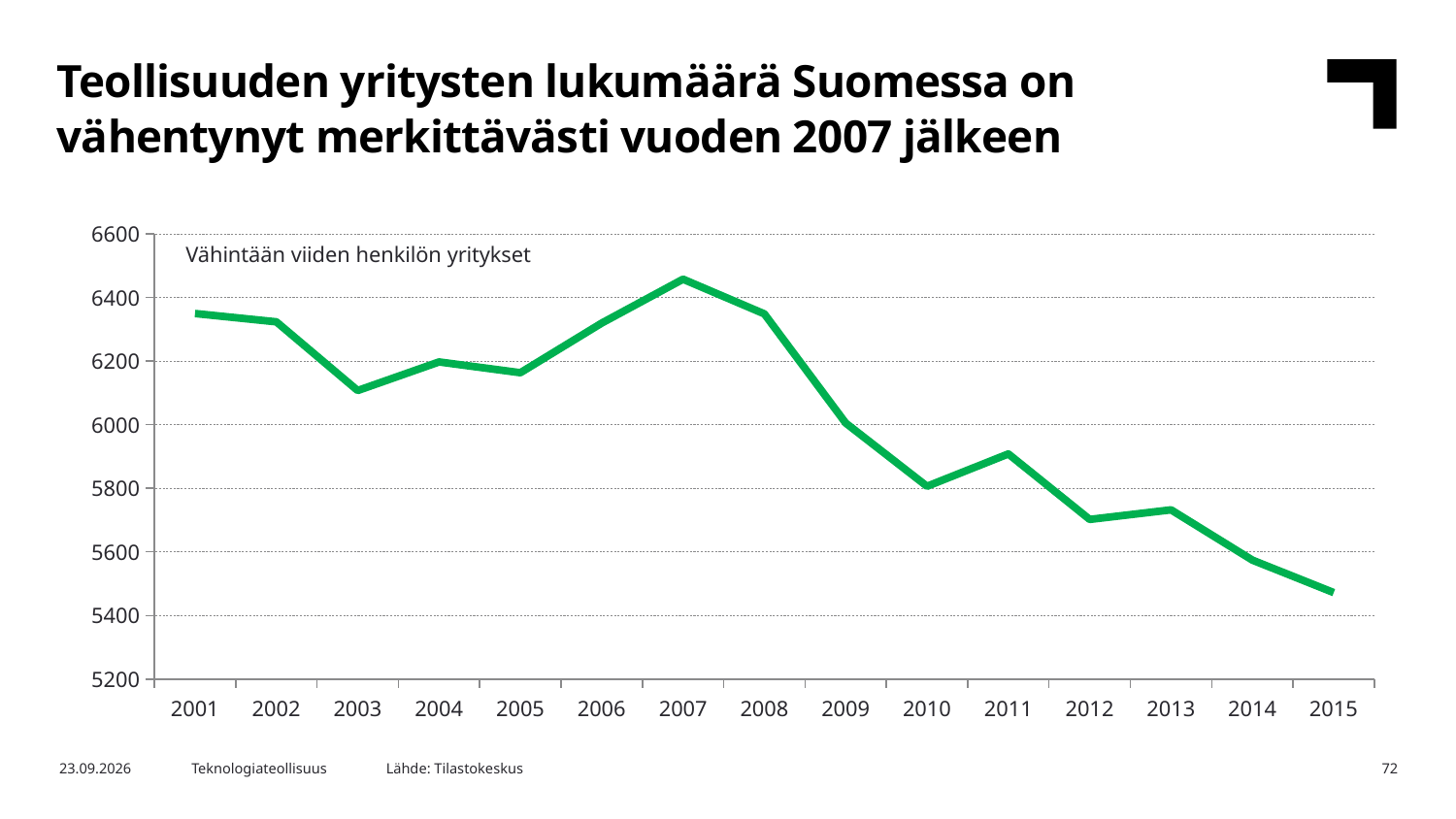
Is the value for 2012 greater or less than 5800? less Which year has a higher value, 2001 or 2012? 2001 In which year is the number of industrial companies highest? 2007 Is the value for 2015 greater or less than 5600? less How many years are plotted along the x axis? 15 Do the values rise or fall from 2007 to 2015? fall What text label is shown inside the plot area of the chart? Vähintään viiden henkilön yritykset In which year is the number of industrial companies lowest? 2015 Is the value for 2007 greater or less than 6400? greater What kind of chart is shown on the slide? line chart